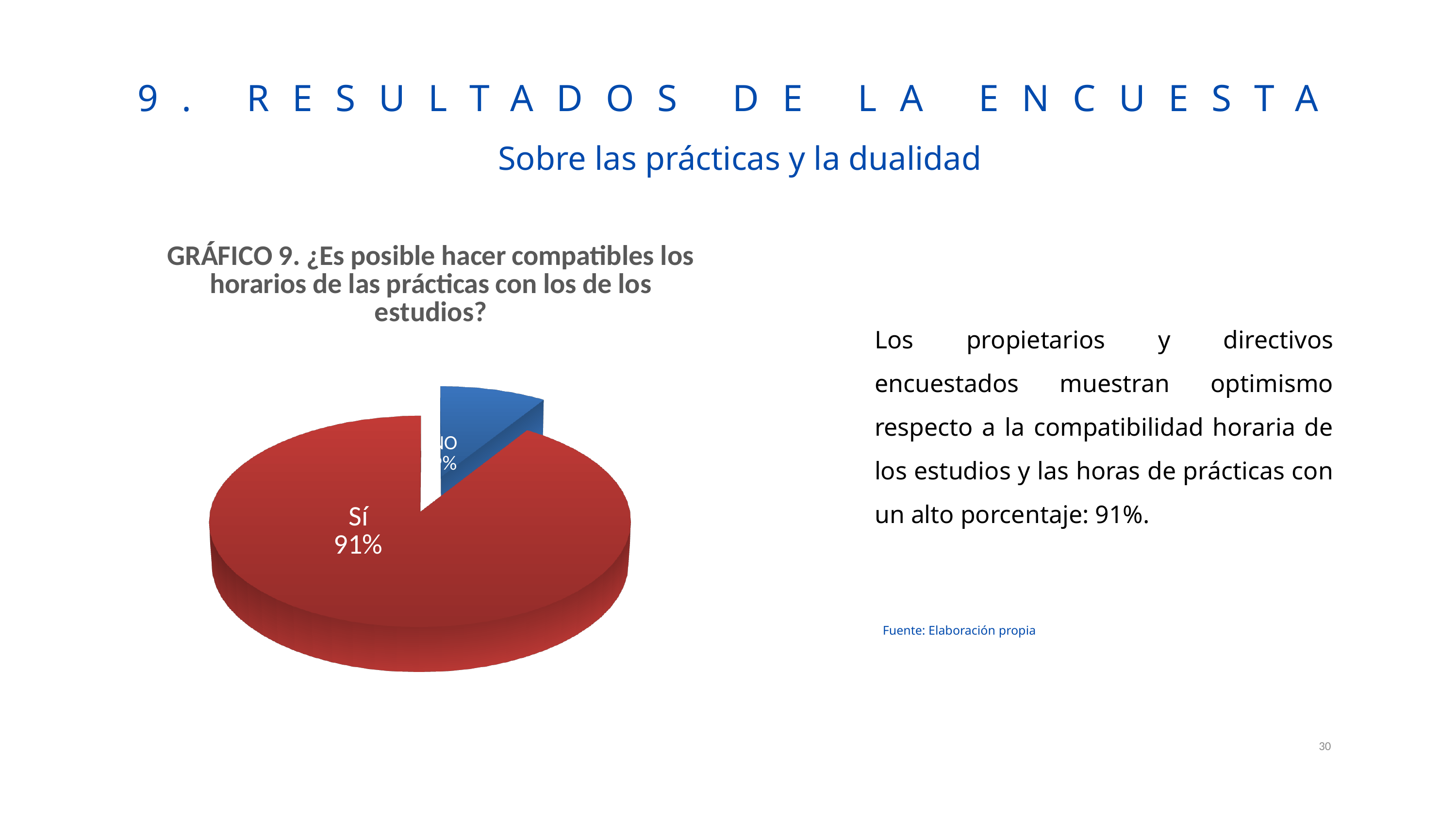
Which is larger, the "Sí" slice or the "NO" slice? Sí What colour is the "Sí" slice of the pie? red Which slice of the pie is the largest? Sí Which slice of the pie is the smallest? NO How many slices does the pie chart have? 2 What kind of chart is GRÁFICO 9? pie chart What is the title of the pie chart? GRÁFICO 9. ¿Es posible hacer compatibles los horarios de las prácticas con los de los estudios? What share of the pie does the "Sí" slice represent? 91%